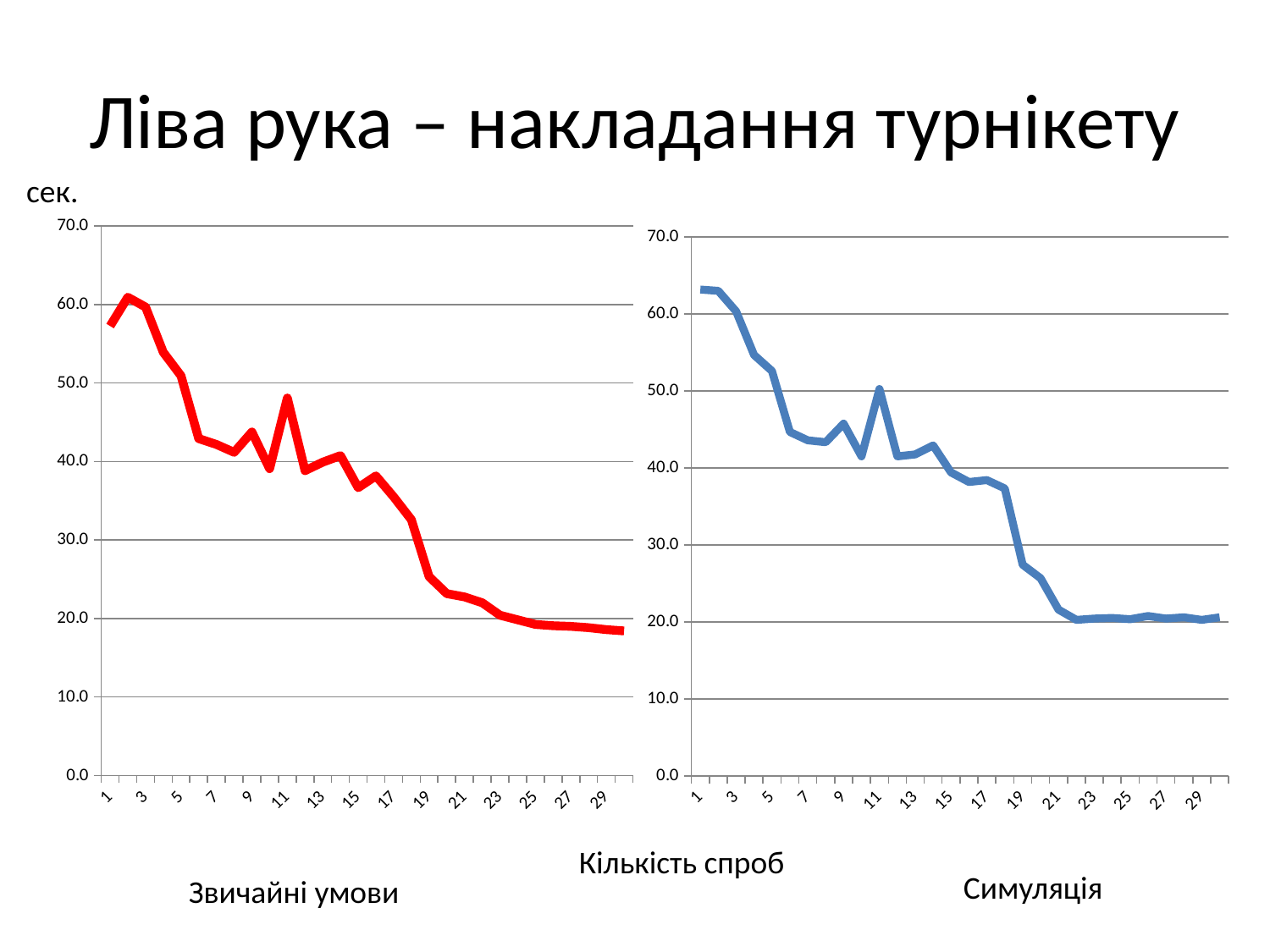
In the left chart (Звичайні умови), is the value for attempt 1 greater or less than 50? greater In the right chart (Симуляція), do the values generally rise or fall along the x axis? fall In the left chart (Звичайні умови), at which attempt number is the value highest? 2 What colour is the line in the right chart (Симуляція)? blue In the right chart (Симуляція), which is larger: the value for attempt 3 or the value for attempt 21? attempt 3 What kind of chart is the left chart (Звичайні умови)? line chart In the left chart (Звичайні умови), do the values generally rise or fall as the number of attempts increases? fall What is the label of the shared x axis shown below the charts? Кількість спроб In the left chart (Звичайні умови), is the value for attempt 29 greater or less than 20? less In the right chart (Симуляція), is the value for attempt 19 greater or less than 30? less In the left chart (Звичайні умови), which is larger: the value for attempt 1 or the value for attempt 29? attempt 1